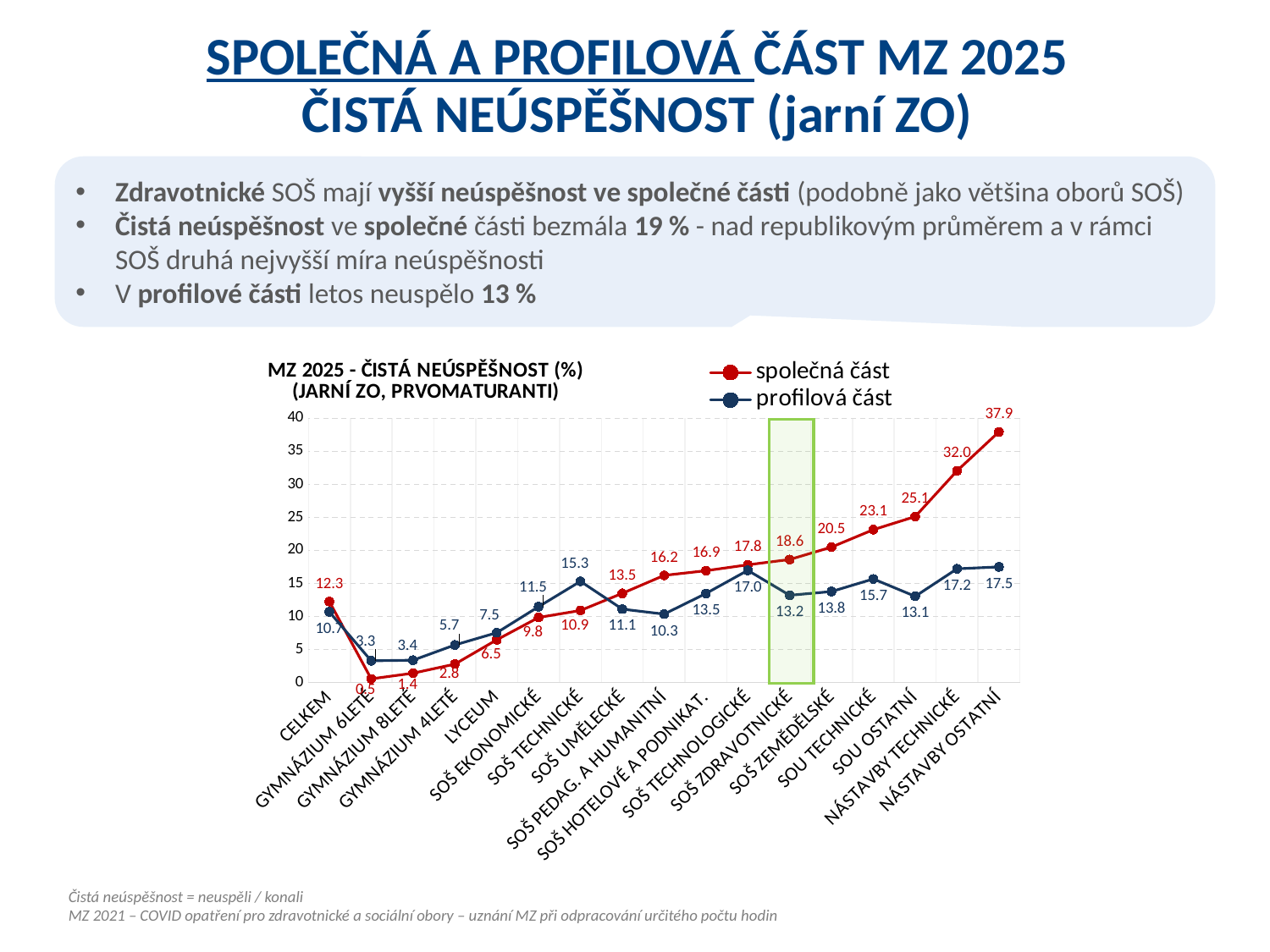
What kind of chart is shown on the slide? line chart What is the value of profilová část for SOŠ ZDRAVOTNICKÉ? 13.2 How many categories are shown on the x axis? 17 Is the value of společná část for NÁSTAVBY TECHNICKÉ greater or less than 30? greater What is the difference between společná část and profilová část for SOŠ ZDRAVOTNICKÉ? 5.4 For SOŠ TECHNICKÉ, which is larger: společná část or profilová část? profilová část Which category has the highest value of společná část? NÁSTAVBY OSTATNÍ What is the value of společná část for CELKEM? 12.3 What is the value of společná část for SOŠ ZDRAVOTNICKÉ? 18.6 What is the value of profilová část for SOŠ TECHNICKÉ? 15.3 Which category has the lowest value of společná část? GYMNÁZIUM 6LETÉ How many series does the legend list? 2